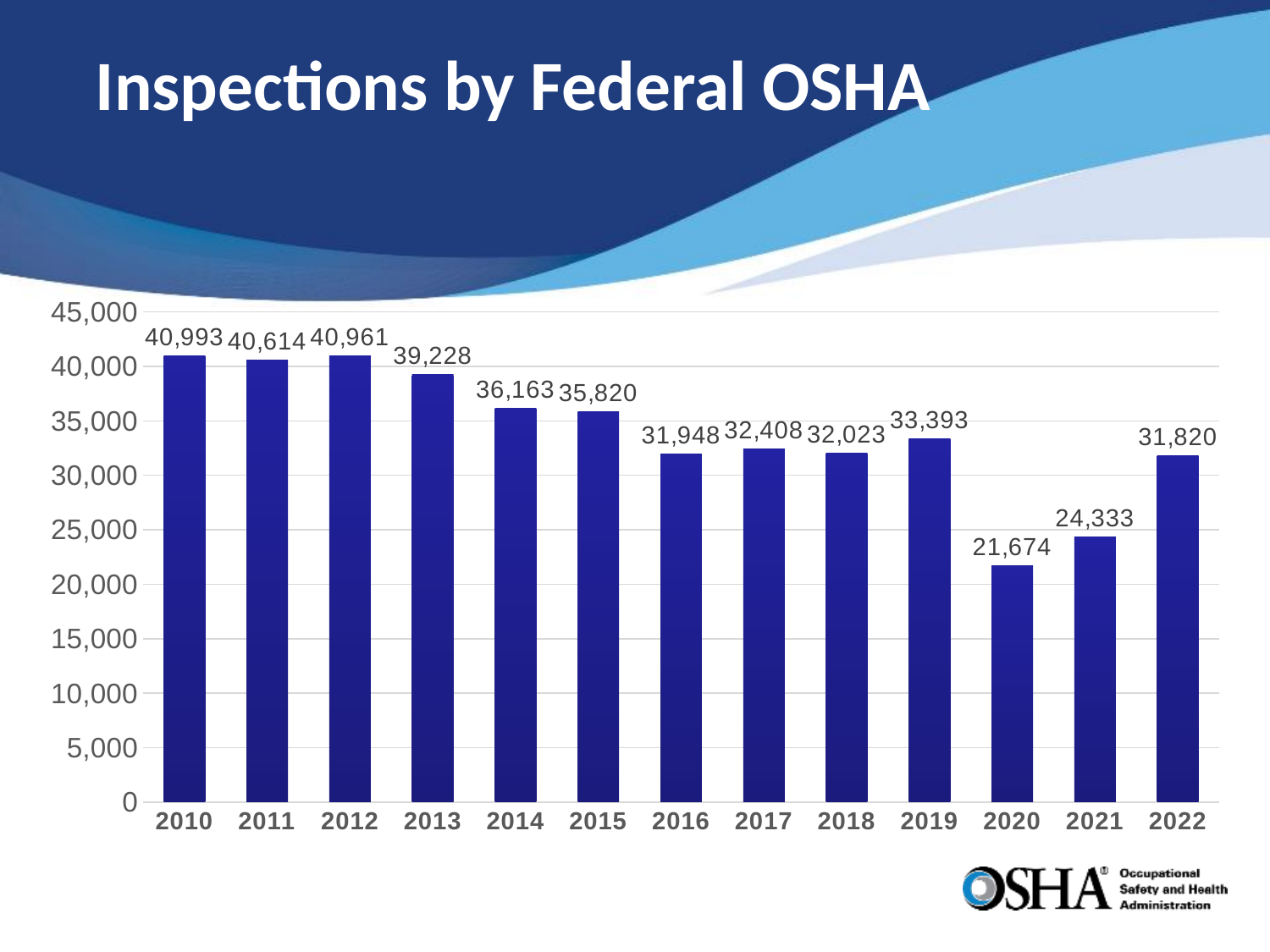
Which year has the lowest number of inspections? 2020 What is the difference between the 2022 and 2021 values? 7,487 What is the title of the chart? Inspections by Federal OSHA How many inspections did Federal OSHA conduct in 2013? 39,228 What is the value shown for 2020? 21,674 How many years are shown on the x axis? 13 Is the value for 2020 greater or less than 25,000? less What is the difference between the 2021 and 2020 values? 2,659 Which year had more inspections, 2017 or 2018? 2017 What is the value shown for 2022? 31,820 What kind of chart is shown on the slide? bar chart Which year has the highest number of inspections? 2010